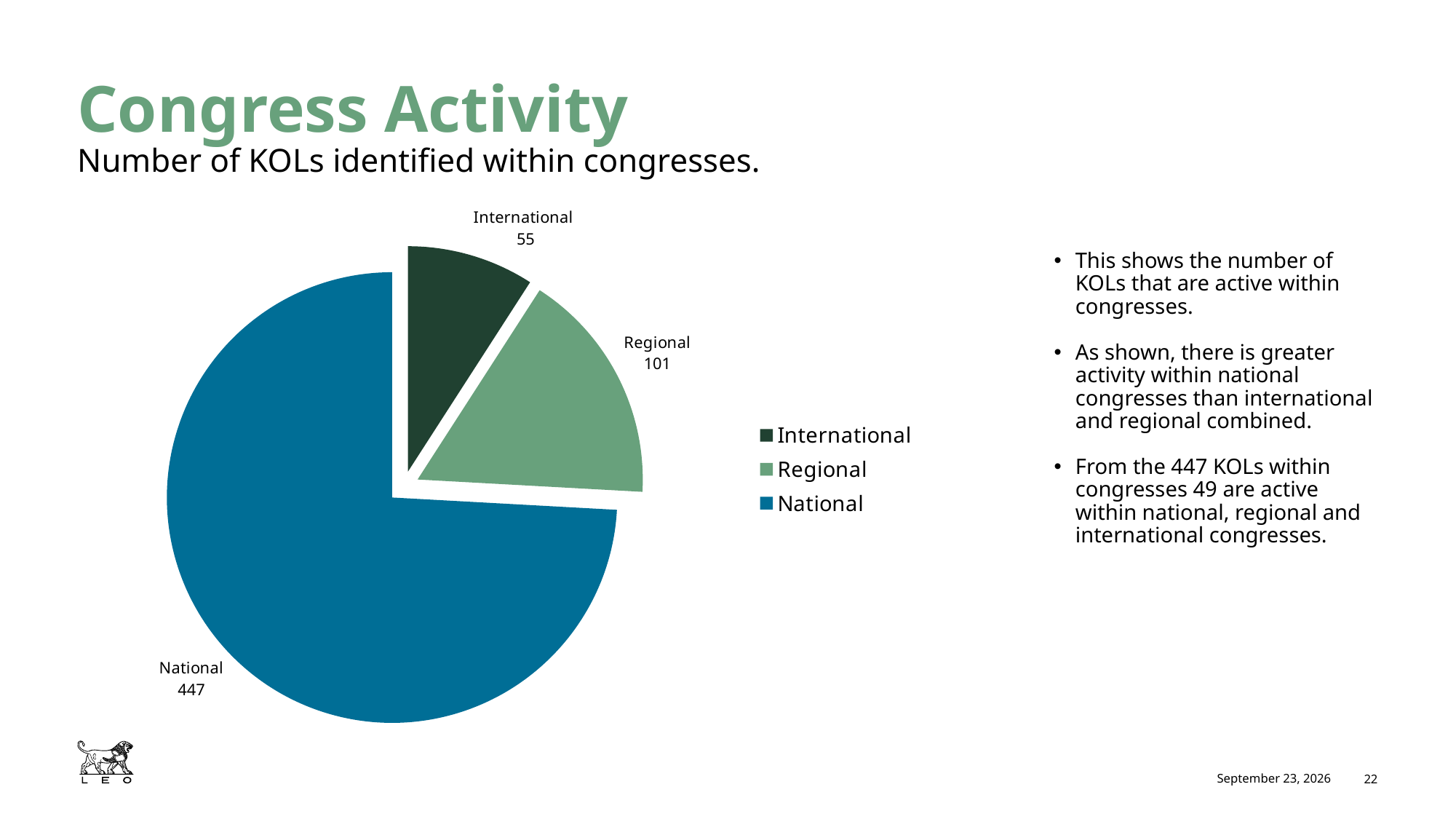
What is the difference between the number of KOLs in National and Regional congresses? 346 Which has more KOLs, Regional or International congresses? Regional What share of the total KOLs does the National slice represent? 74.1% Which congress category has the smallest number of KOLs? International What kind of chart is shown on the slide? Pie chart How many categories are shown in the pie chart? 3 Which category is shown in the dark green slice of the pie chart? International How many KOLs are identified within National congresses? 447 Which congress category has the largest number of KOLs? National How many KOLs are identified within Regional congresses? 101 What is the difference between the number of KOLs in Regional and International congresses? 46 How many KOLs are identified within International congresses? 55